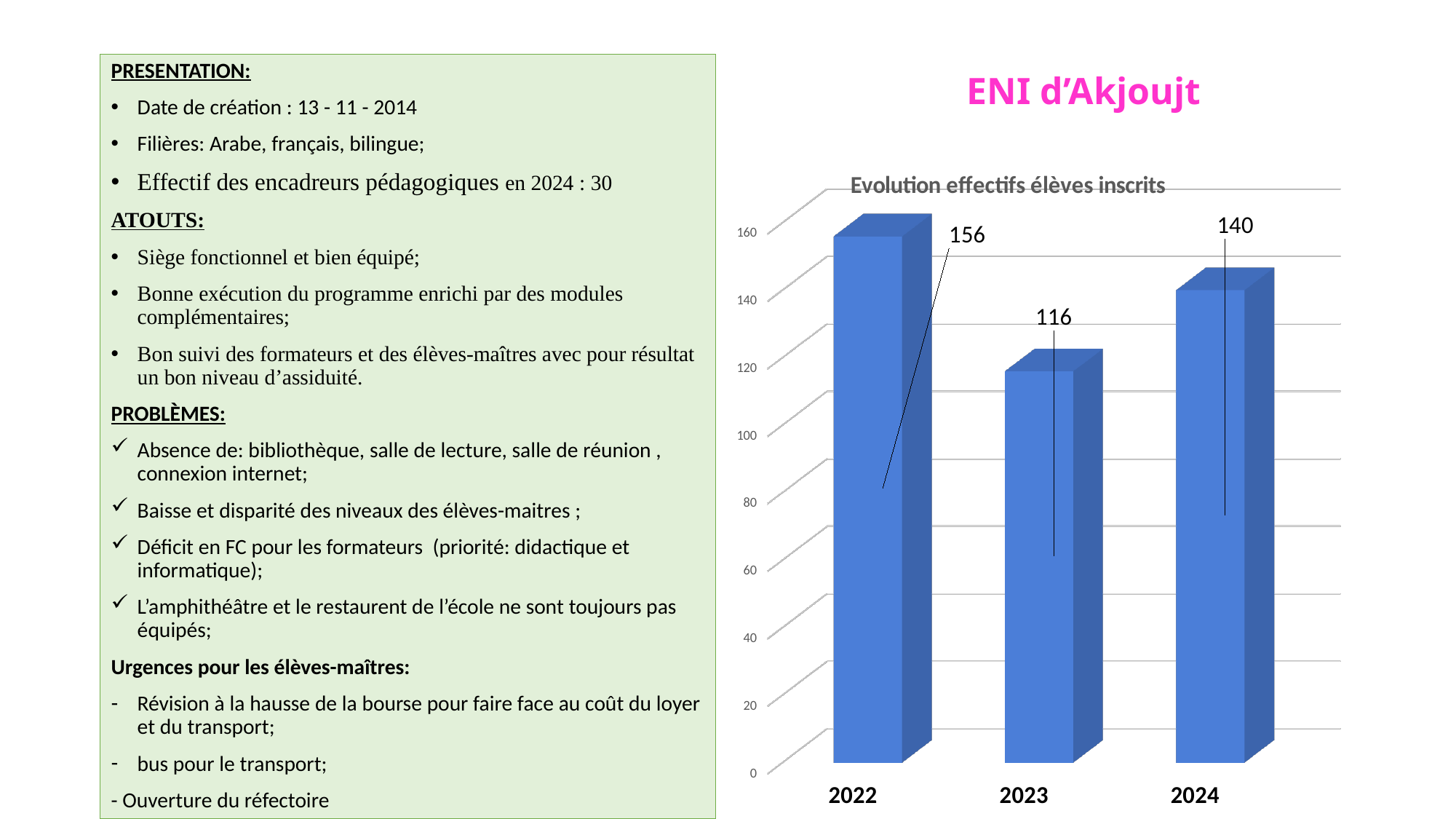
Which year has the lowest value in the chart? 2023 Is the value for 2023 greater or less than 120? less What is the title of the chart? Evolution effectifs élèves inscrits What is the value for 2024 in the chart? 140 What is the difference between the values for 2024 and 2023? 24 What kind of chart is shown on the slide? bar chart Which is larger, the value for 2022 or the value for 2024? 2022 What is the value for 2023 in the chart? 116 How many years are shown on the x axis of the chart? 3 What is the difference between the values for 2022 and 2023? 40 Which year has the highest value in the chart? 2022 What is the value for 2022 in the chart? 156